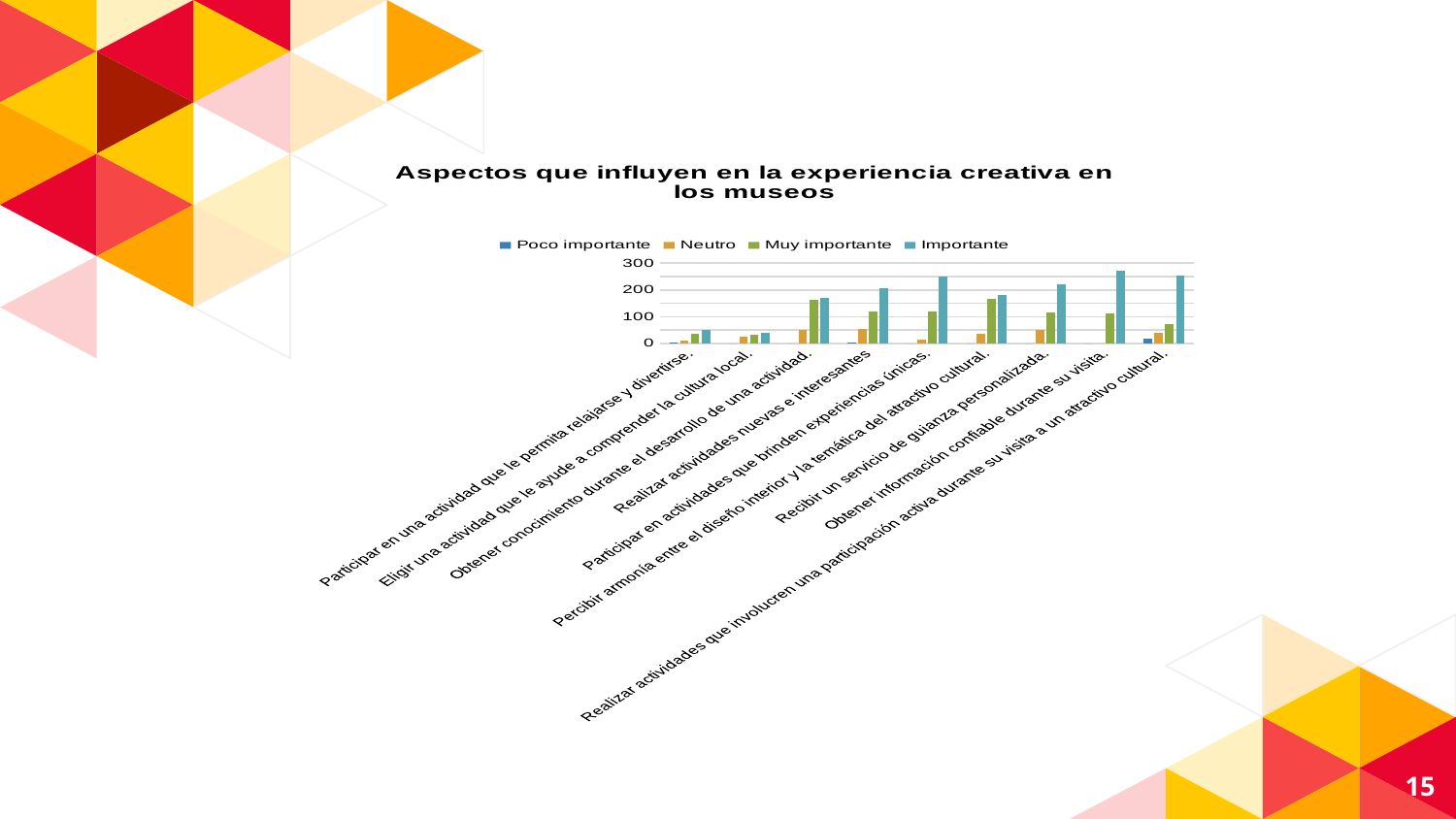
Is the 'Importante' value for 'Participar en una actividad que le permita relajarse y divertirse.' greater or less than 100? less Is the 'Importante' value for 'Obtener información confiable durante su visita.' greater or less than 200? greater Is the 'Muy importante' value for 'Obtener conocimiento durante el desarrollo de una actividad.' greater or less than 100? greater How many categories are shown on the x axis? 9 What kind of chart is shown on the slide? bar chart Which series is listed first in the legend? Poco importante What is the title of the chart? Aspectos que influyen en la experiencia creativa en los museos For 'Participar en actividades que brinden experiencias únicas.', which is larger: the 'Importante' value or the 'Muy importante' value? Importante Which category has the lowest 'Importante' value? Eligir una actividad que le ayude a comprender la cultura local. How many series does the legend list? 4 Which category has the highest 'Importante' value? Obtener información confiable durante su visita.